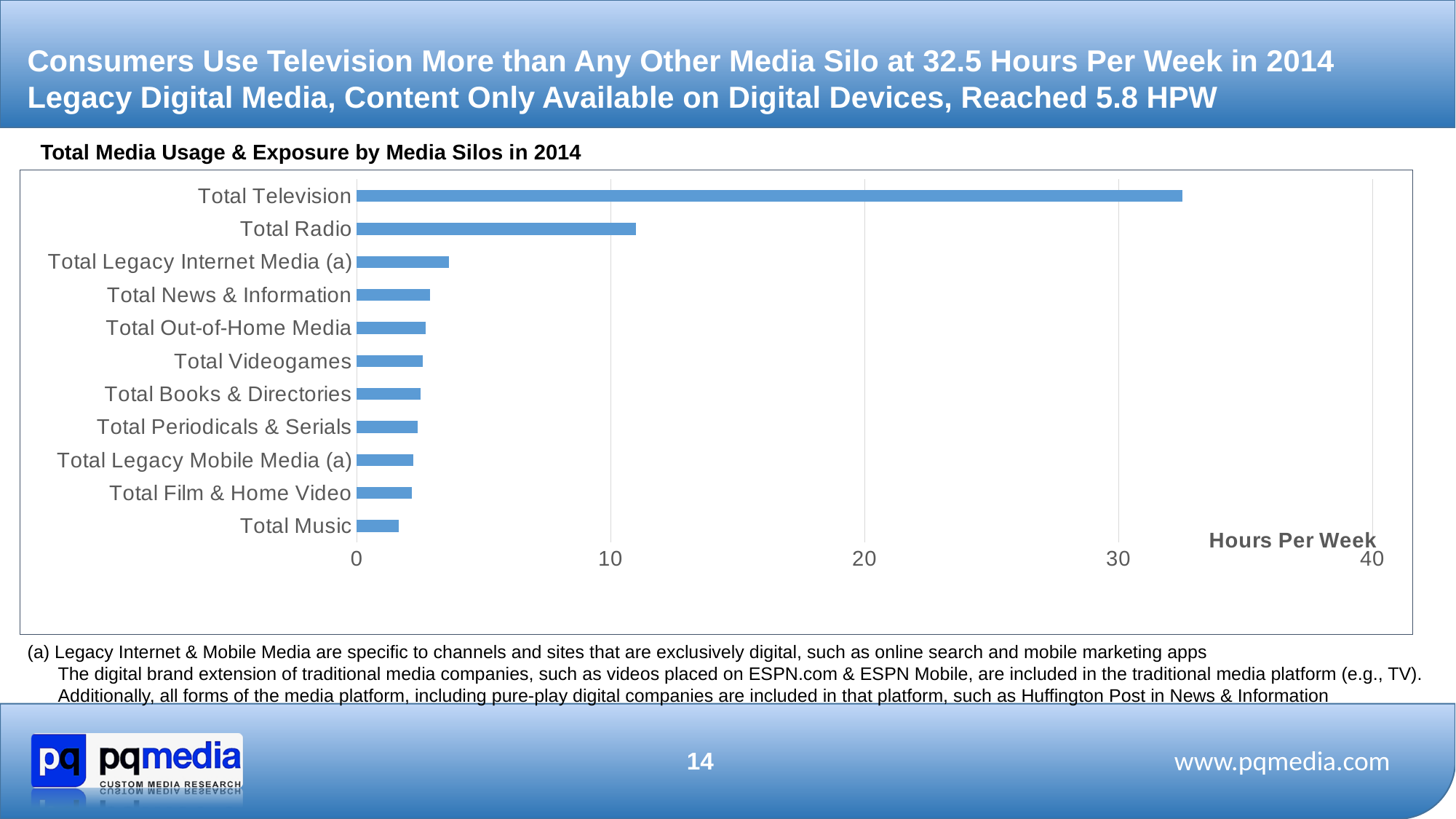
Which has more hours per week, Total Television or Total Radio? Total Television Which media silo has the highest hours per week in the chart? Total Television What unit is shown on the horizontal axis of the chart? Hours Per Week What is the title of the chart? Total Media Usage & Exposure by Media Silos in 2014 Is the value for Total Music greater or less than 10 hours per week? less Which media silo has the lowest hours per week in the chart? Total Music Is the value for Total Television greater or less than 30 hours per week? greater What type of chart is shown on the slide? Bar chart Is the value for Total Legacy Internet Media (a) greater or less than 10 hours per week? less How many media silos (categories) are plotted in the chart? 11 According to the slide, how many hours per week did consumers use television in 2014? 32.5 Which has more hours per week, Total Radio or Total Music? Total Radio